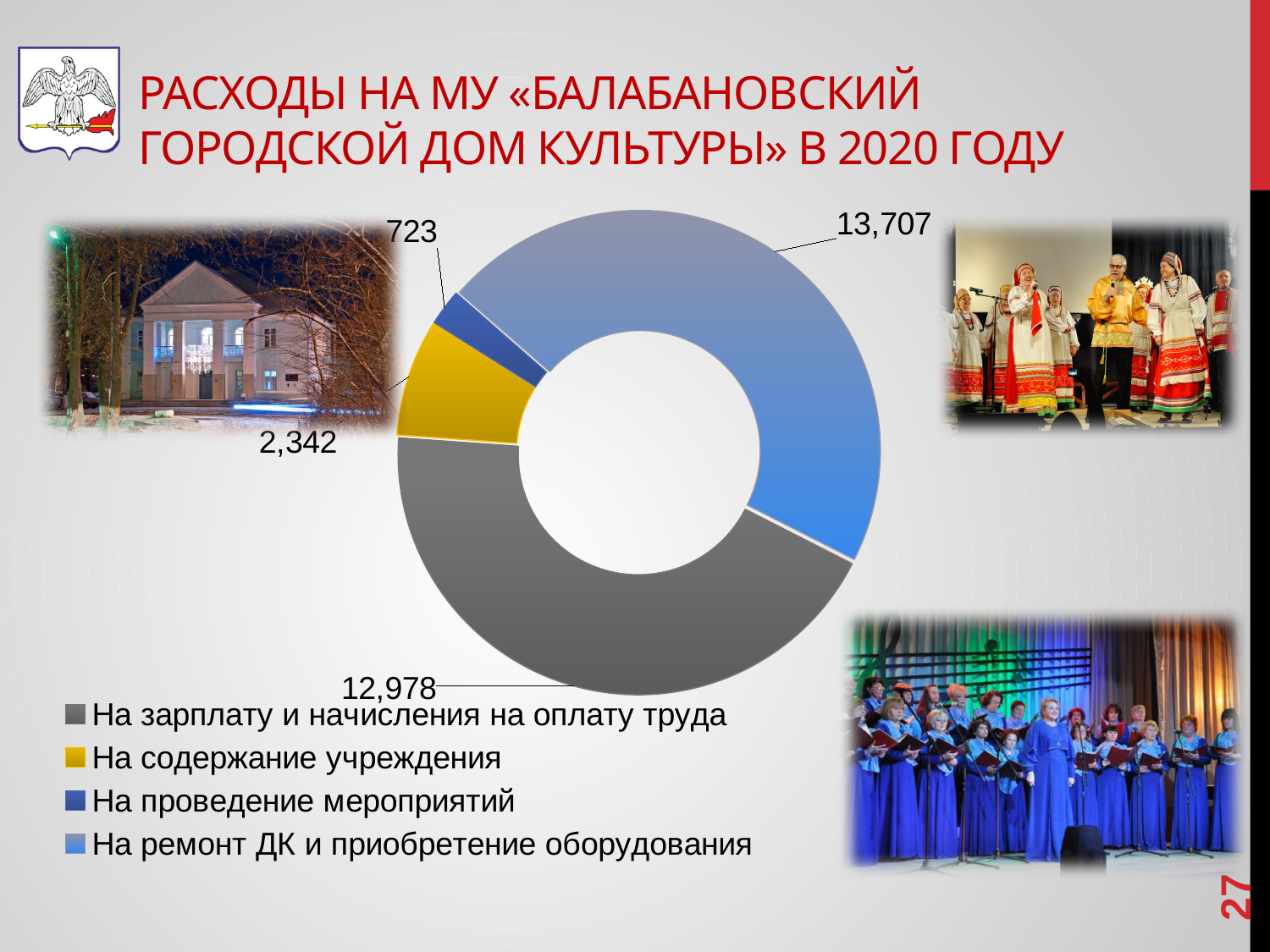
Which category has the smallest value? На проведение мероприятий What is the difference between the values for «На содержание учреждения» and «На проведение мероприятий»? 1,619 What is the difference between the values for «На ремонт ДК и приобретение оборудования» and «На зарплату и начисления на оплату труда»? 729 How many categories does the chart show? 4 Which is larger: «На содержание учреждения» or «На проведение мероприятий»? На содержание учреждения What value is shown for «На зарплату и начисления на оплату труда»? 12,978 Which category has the largest value? На ремонт ДК и приобретение оборудования What value is shown for «На содержание учреждения»? 2,342 What type of chart is shown on the slide? Doughnut (pie) chart What value is shown for «На ремонт ДК и приобретение оборудования»? 13,707 What colour represents «На содержание учреждения» in the chart? Yellow What value is shown for «На проведение мероприятий»? 723